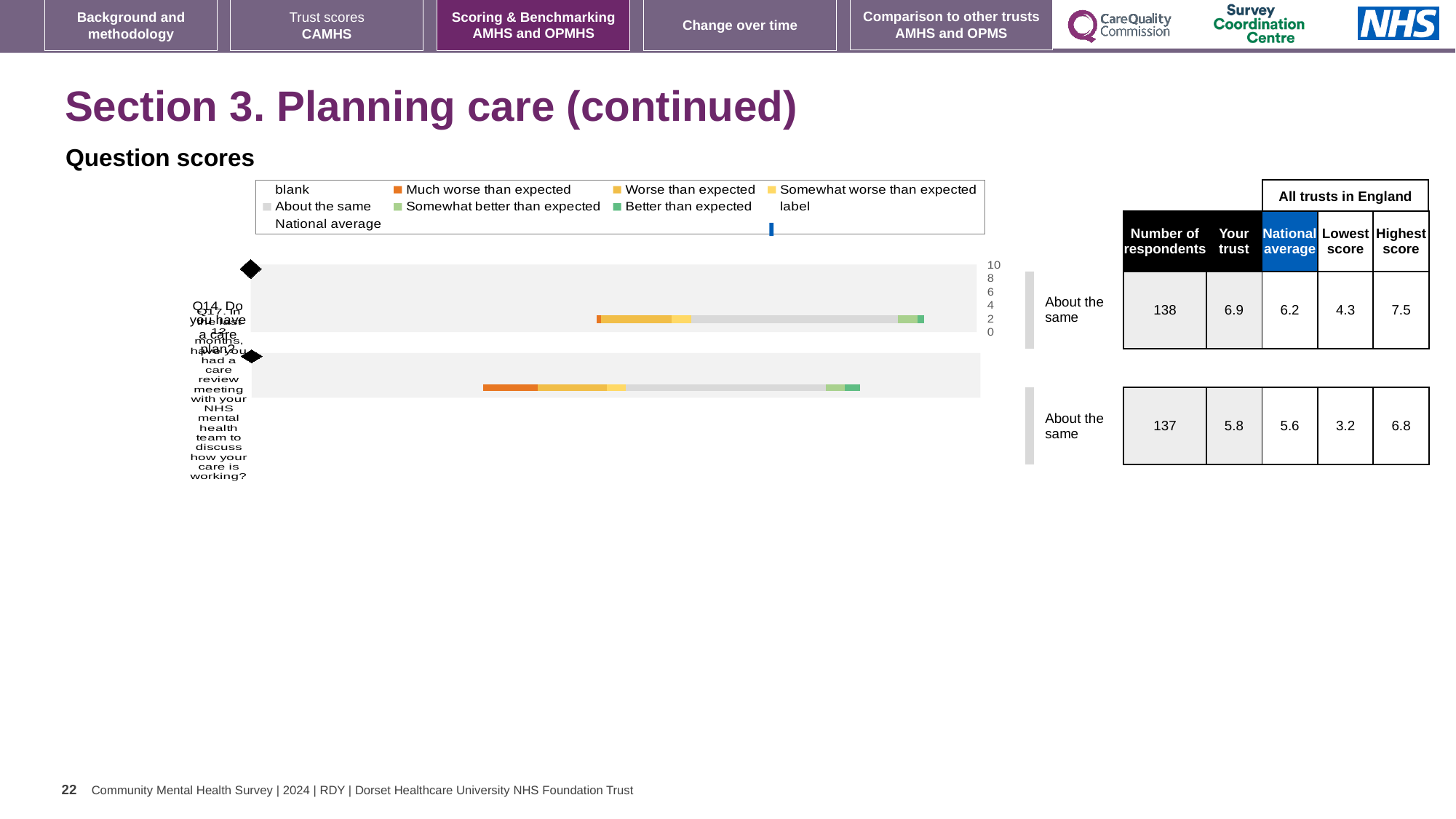
Which question has the higher 'Your trust' score, Q14 or Q17? Q14 In the table beside the chart, what is the national average score for Q17 (care review meeting)? 5.6 By how much does the trust's score for Q14 exceed the national average? 0.7 What colour represents 'Much worse than expected' in the chart legend? orange In the table beside the chart, what is the 'Your trust' score for Q14 (Do you have a care plan?)? 6.9 How many questions (bars) are plotted in the question scores chart? 2 What benchmark category is shown for Q17 next to the chart? About the same What type of chart is used to show the question scores on this slide? bar chart What is the difference between the highest and lowest scores for Q14? 3.2 What is the lowest score across all trusts in England for Q14? 4.3 How many respondents answered Q14 according to the table? 138 What is the highest score across all trusts in England for Q17? 6.8